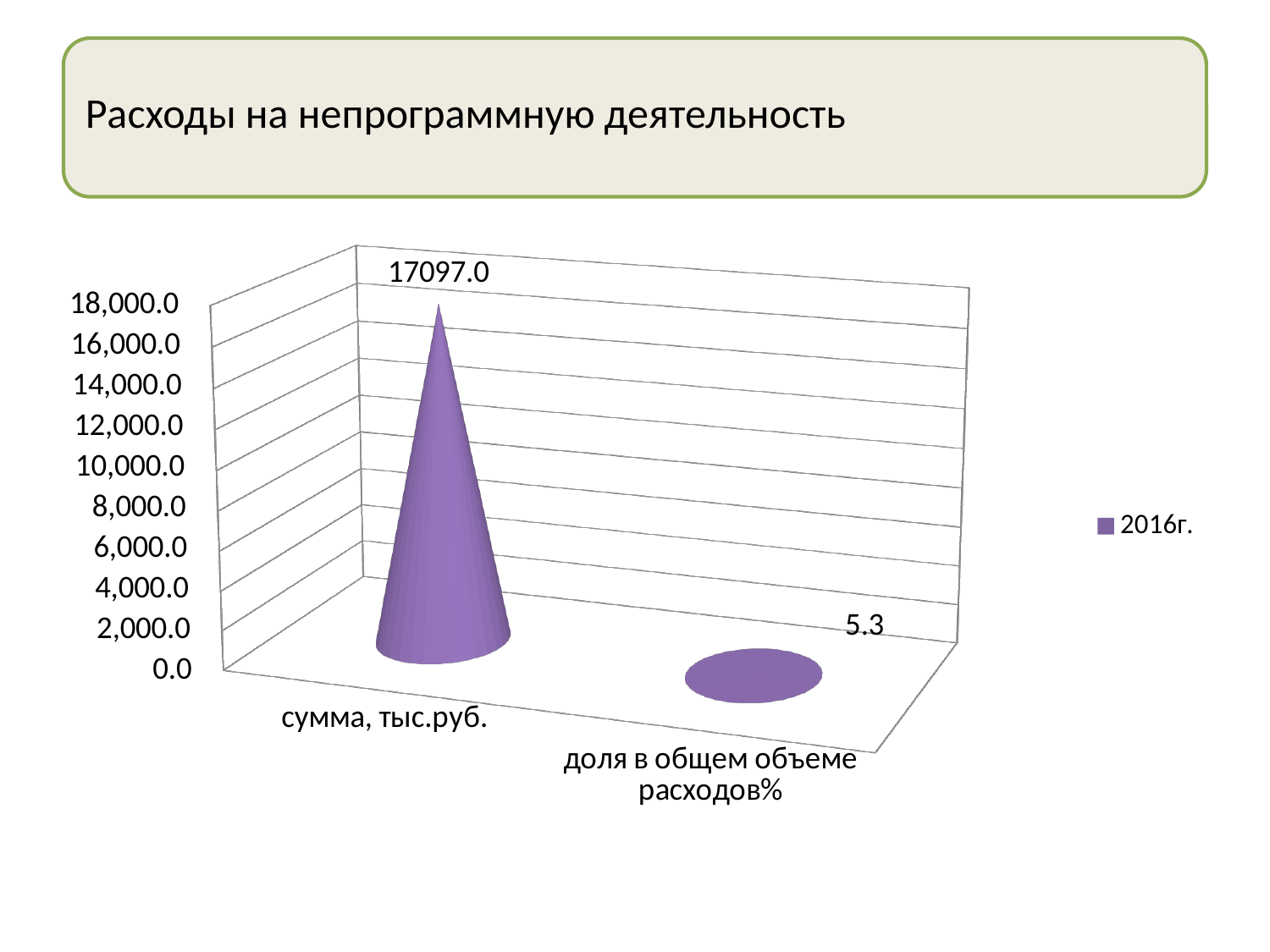
Is the value for "доля в общем объеме расходов%" greater or less than 2,000.0? less How many series does the legend list? 1 Which category has the lowest value? доля в общем объеме расходов% What is the value for "сумма, тыс.руб."? 17097.0 What is the difference between the value for "сумма, тыс.руб." and the value for "доля в общем объеме расходов%"? 17091.7 Which is larger: the value for "сумма, тыс.руб." or the value for "доля в общем объеме расходов%"? сумма, тыс.руб. Is the value for "сумма, тыс.руб." greater or less than 16,000.0? greater How many categories are shown on the x axis? 2 What kind of chart is shown on the slide? bar chart Which category has the highest value? сумма, тыс.руб. What is the value for "доля в общем объеме расходов%"? 5.3 What series name is shown in the legend? 2016г.